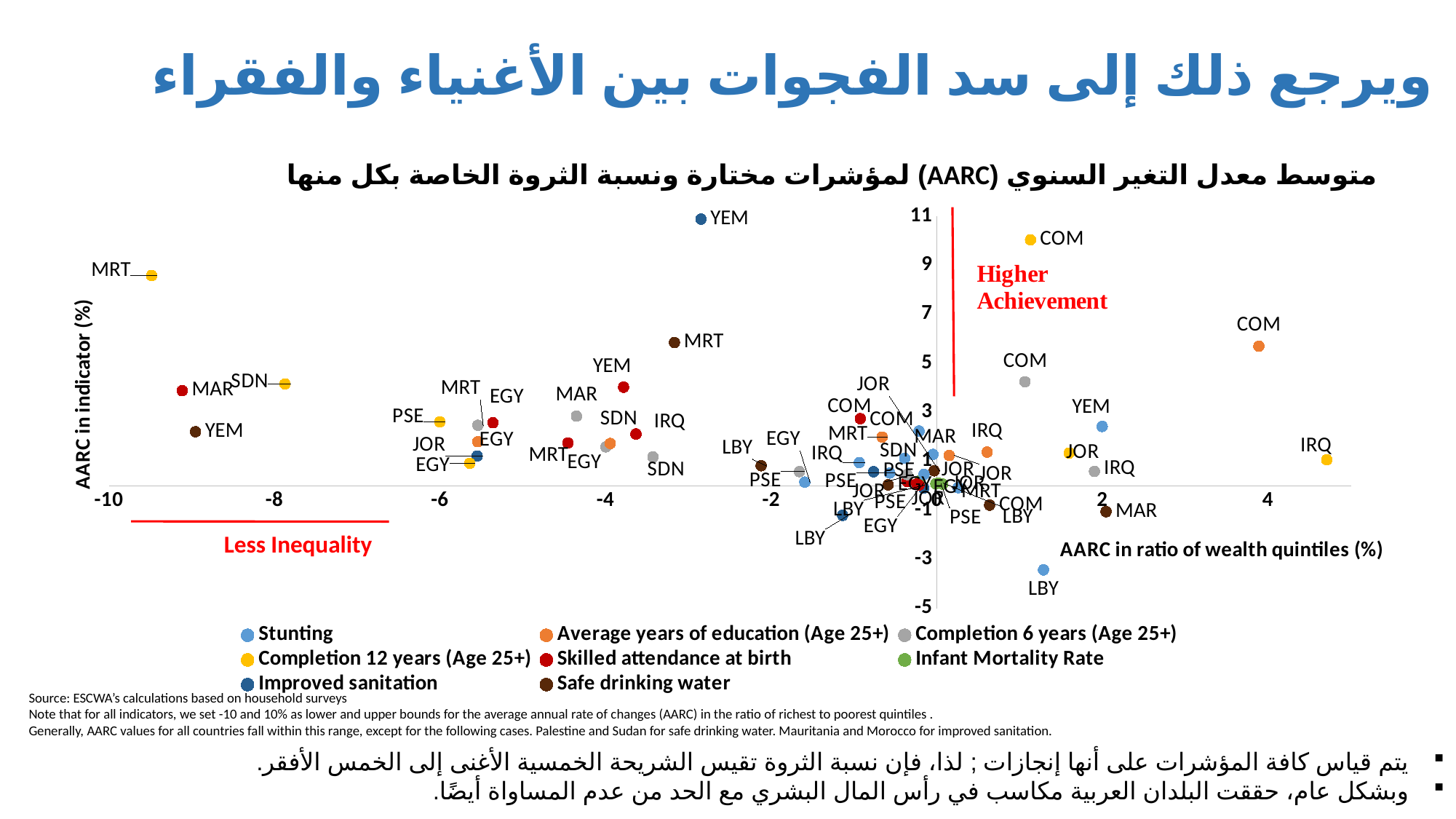
Is the AARC in indicator (%) for the Stunting point LBY at the bottom of the chart greater or less than -1? less What kind of chart is shown on the slide? scatter chart Which labelled point has the highest AARC in indicator (%) on the chart? YEM (Improved sanitation) Is the AARC in indicator (%) for the Improved sanitation point YEM at the top of the chart greater or less than 9? greater Which labelled point lies furthest to the left on the horizontal axis? MRT (Completion 12 years) Which labelled point has the lowest AARC in indicator (%) on the chart? LBY (Stunting) What is the title of the horizontal axis of the chart? AARC in ratio of wealth quintiles (%) How many series does the chart legend list? 8 Is the AARC in ratio of wealth quintiles (%) for the Completion 12 years point MRT at the far left greater or less than -8? less What is the title of the vertical axis of the chart? AARC in indicator (%) Which has the higher AARC in indicator (%): the Safe drinking water point MRT or the Skilled attendance at birth point YEM? MRT (Safe drinking water)